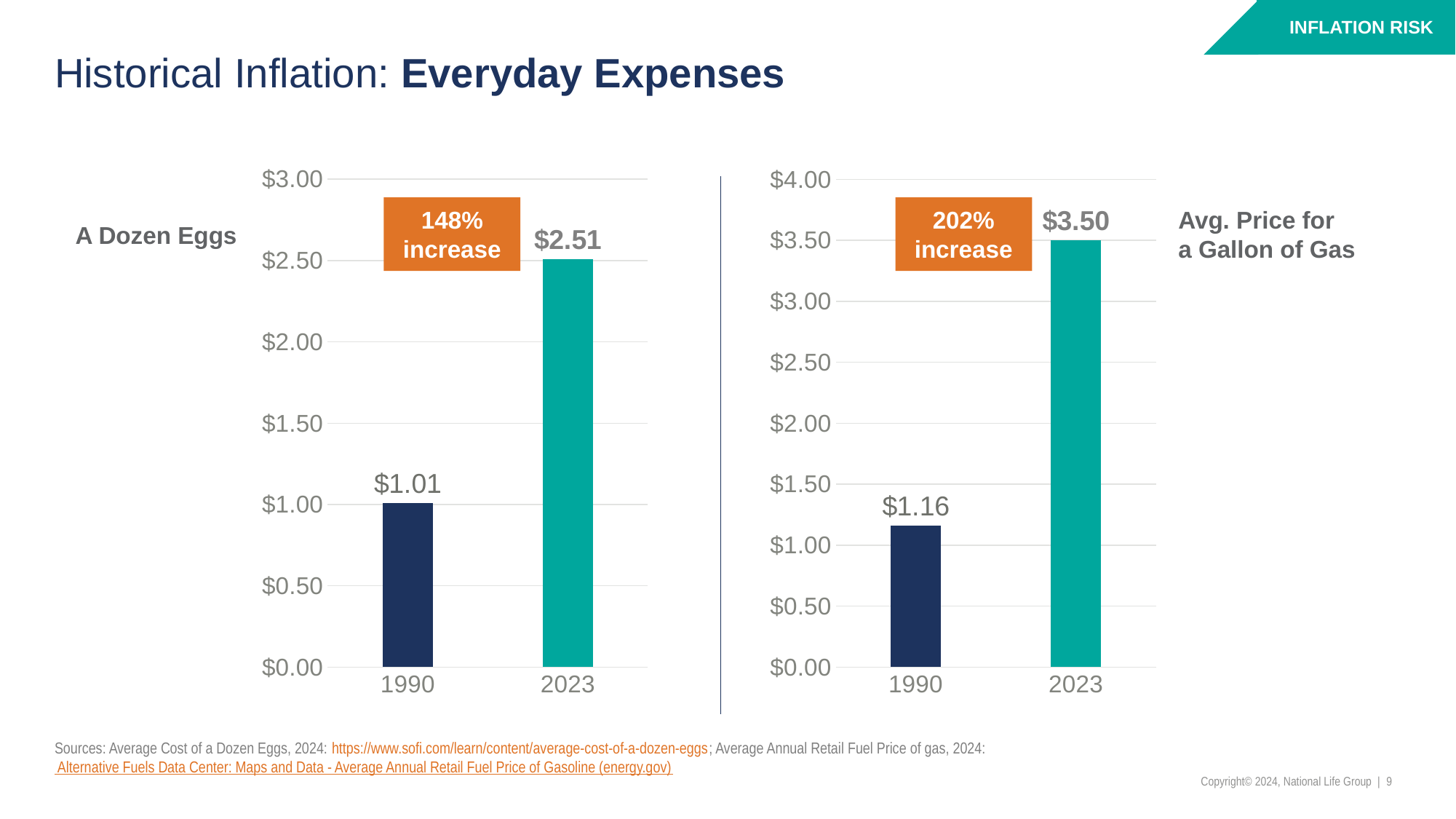
In the 'A Dozen Eggs' chart, which year has the lowest value? 1990 In the 'Avg. Price for a Gallon of Gas' chart, what is the value for 1990? $1.16 In the 'A Dozen Eggs' chart, what is the difference between the 2023 and 1990 values? $1.50 In the 'Avg. Price for a Gallon of Gas' chart, which year has the higher value? 2023 In the 'A Dozen Eggs' chart, what is the value for 1990? $1.01 In the 'A Dozen Eggs' chart, what is the value for 2023? $2.51 How many bars are plotted in the 'Avg. Price for a Gallon of Gas' chart? 2 In the 'A Dozen Eggs' chart, is the value for 2023 greater or less than $2.00? greater What percentage increase is labelled on the 'Avg. Price for a Gallon of Gas' chart? 202% increase What kind of chart is the 'A Dozen Eggs' chart? Bar chart In the 'Avg. Price for a Gallon of Gas' chart, what is the value for 2023? $3.50 In the 'Avg. Price for a Gallon of Gas' chart, what is the difference between the 2023 and 1990 values? $2.34